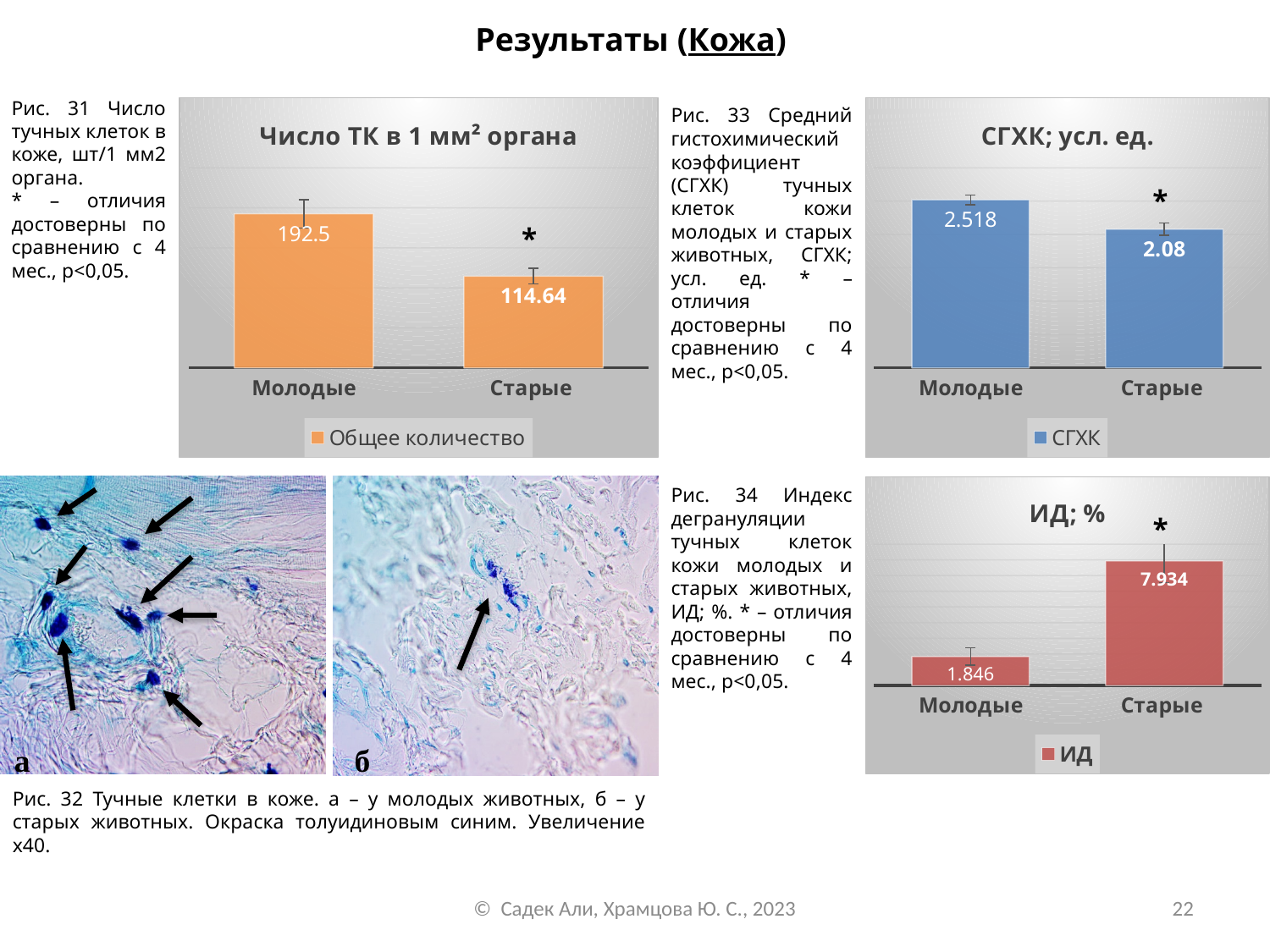
In the chart titled "ИД; %", what is the value for Молодые? 1.846 In the chart titled "СГХК; усл. ед.", what is the value for Старые? 2.08 In the chart titled "Число ТК в 1 мм² органа", what is the value for Старые? 114.64 In the chart titled "Число ТК в 1 мм² органа", what is the difference between the values for Молодые and Старые? 77.86 In the chart titled "ИД; %", what is the difference between the values for Старые and Молодые? 6.088 In the chart titled "ИД; %", how many categories are shown on the x axis? 2 What kind of chart is the chart titled "СГХК; усл. ед."? Bar chart In the chart titled "СГХК; усл. ед.", what is the value for Молодые? 2.518 In the chart titled "Число ТК в 1 мм² органа", what is the value for Молодые? 192.5 In the chart titled "СГХК; усл. ед.", which category has the lower value? Старые In the chart titled "Число ТК в 1 мм² органа", which category has the higher value? Молодые In the chart titled "ИД; %", what is the value for Старые? 7.934